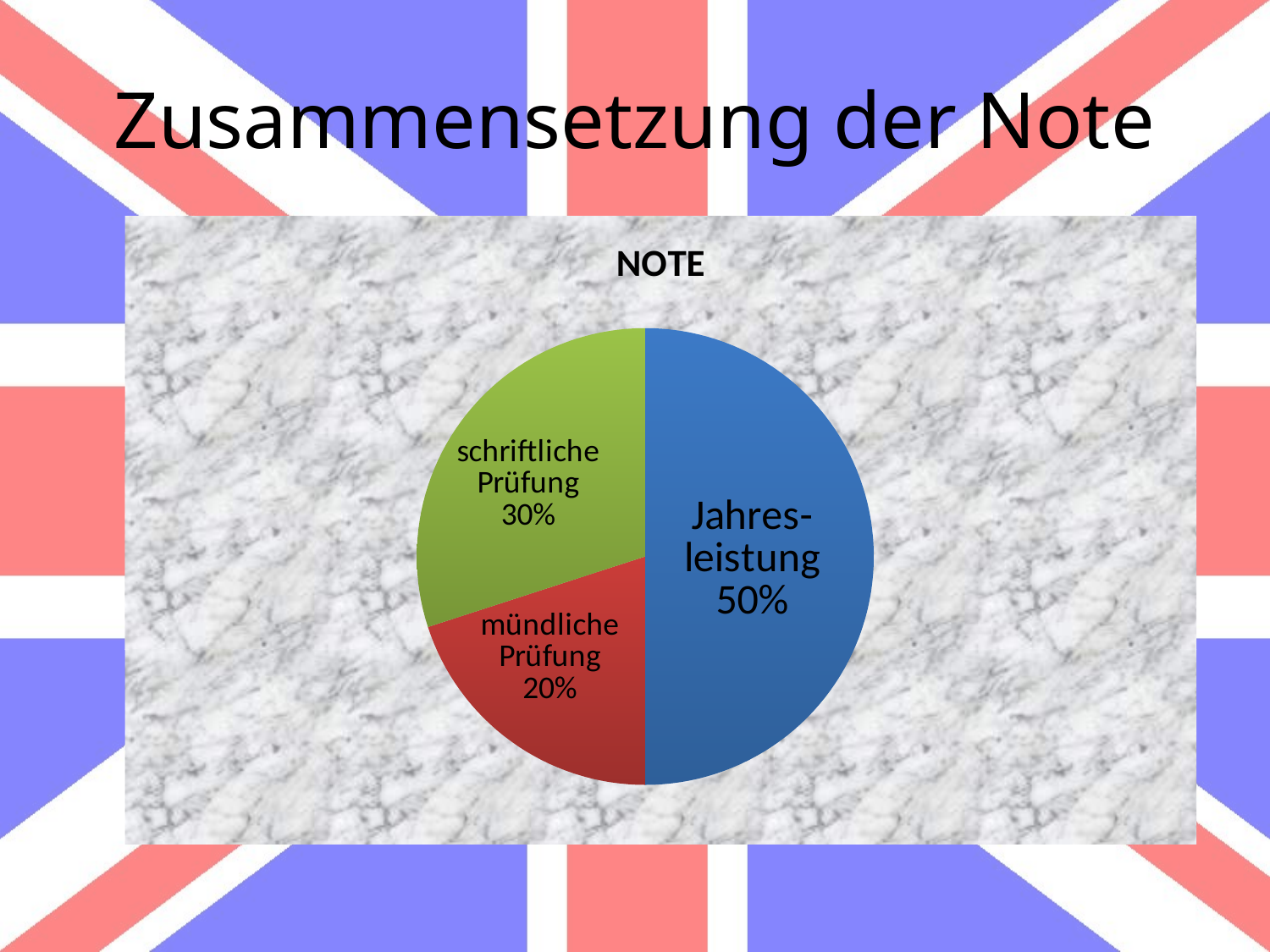
Which slice of the pie is the smallest? mündliche Prüfung What kind of chart is shown on the slide? pie chart What is the value shown for schriftliche Prüfung? 30% What colour is the Jahresleistung slice? blue What is the difference between the shares of Jahresleistung and schriftliche Prüfung? 20% Which slice of the pie is the largest? Jahresleistung What share of the pie does Jahresleistung take? 50% What is the value shown for mündliche Prüfung? 20% How many slices does the pie chart have? 3 What is the difference between the shares of schriftliche Prüfung and mündliche Prüfung? 10% What is the chart's title? NOTE Which is larger, the share for schriftliche Prüfung or the share for mündliche Prüfung? schriftliche Prüfung